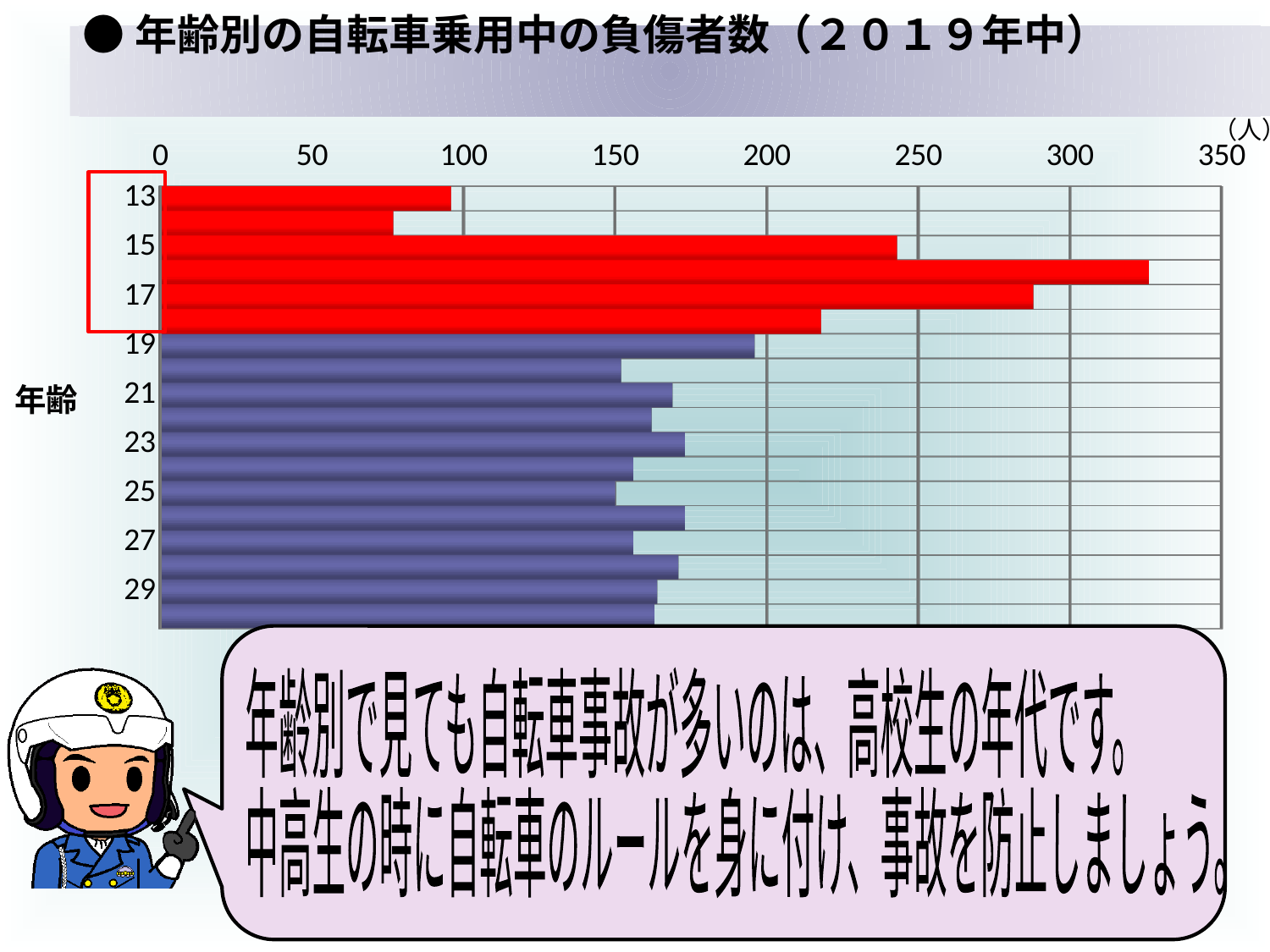
Is the value for age 13 greater or less than 100? less Which has more injured cyclists, age 17 or age 19? 17 Is the value for age 25 greater or less than 200? less What colour are the bars for the ages inside the red box (13 to 18)? red Which has more injured cyclists, age 23 or age 25? 23 Is the value for age 17 greater or less than 250? greater Which has more injured cyclists, age 13 or age 15? 15 What is the highest value shown on the horizontal axis? 350 How many bars (ages) are plotted in the chart? 18 What kind of chart is shown on the slide? bar chart